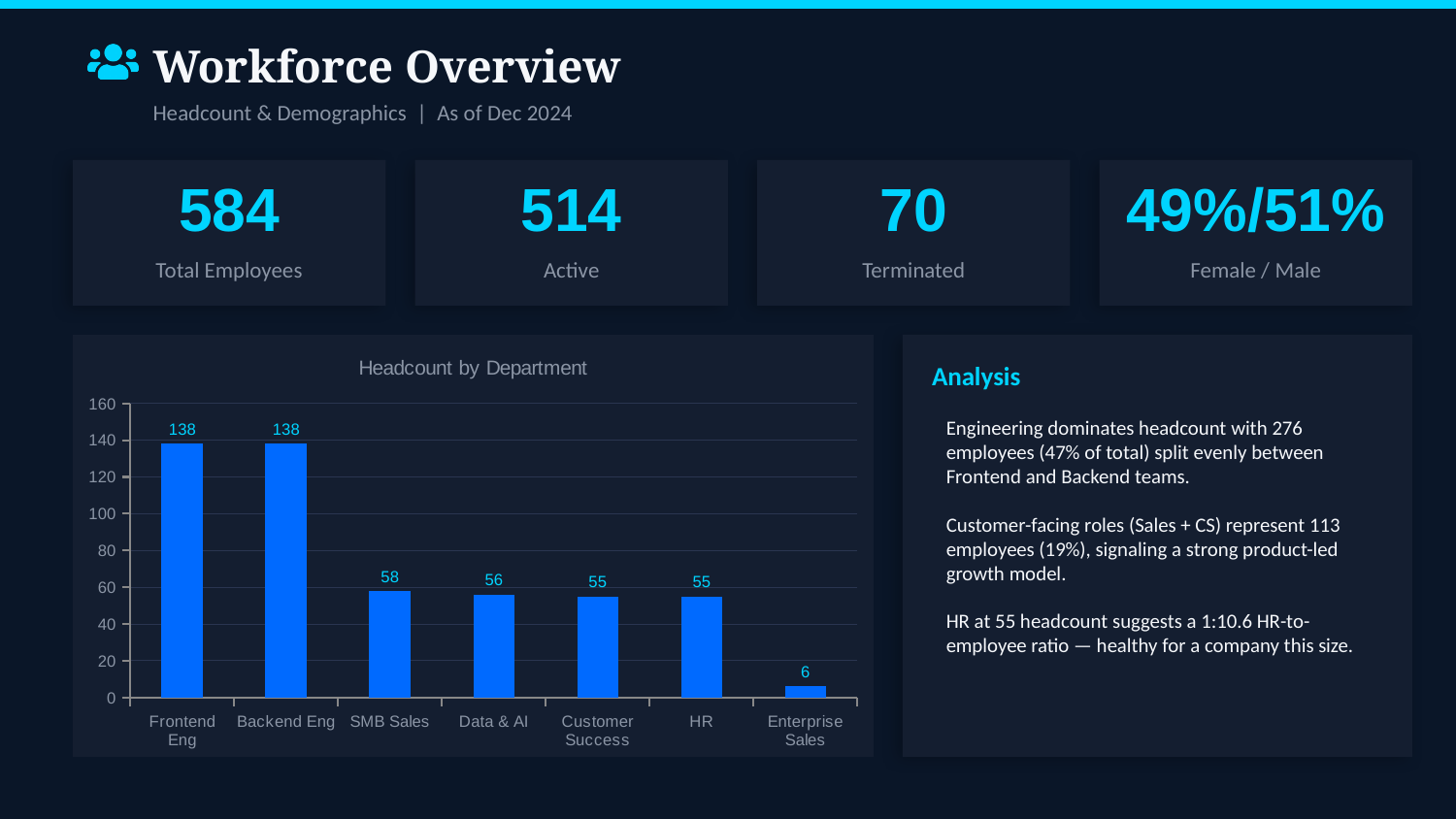
What type of chart is the Headcount by Department chart? bar chart Is the headcount for Customer Success greater or less than 100? less What is the headcount for Data & AI in the Headcount by Department chart? 56 What is the difference in headcount between Frontend Eng and SMB Sales? 80 Do the headcount values generally rise or fall from left to right across the departments? fall How many departments are shown in the Headcount by Department chart? 7 What is the headcount for Enterprise Sales in the Headcount by Department chart? 6 Which has a larger headcount, Backend Eng or Customer Success? Backend Eng Which department has the lowest headcount in the Headcount by Department chart? Enterprise Sales What is the headcount for SMB Sales in the Headcount by Department chart? 58 What is the difference in headcount between HR and Enterprise Sales? 49 What is the headcount for Backend Eng in the Headcount by Department chart? 138